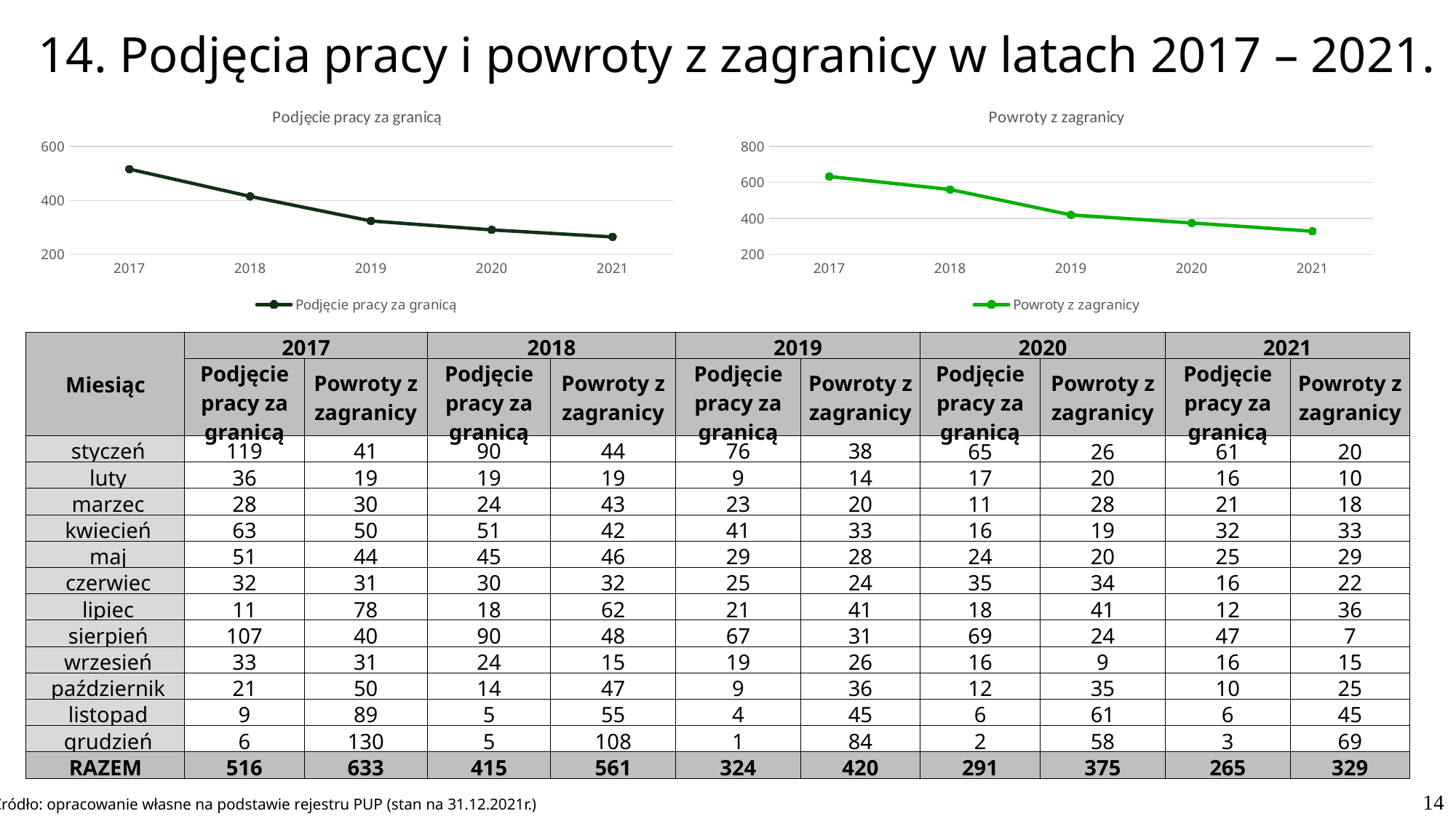
In the "Podjęcie pracy za granicą" chart, is the value for 2019 greater or less than 400? less In the "Powroty z zagranicy" chart, which is larger, the value for 2017 or the value for 2019? 2017 What kind of chart is the "Podjęcie pracy za granicą" chart? line chart In the "Podjęcie pracy za granicą" chart, which year has the highest value? 2017 What colour is the line in the "Powroty z zagranicy" chart? green How many series does the legend of the "Powroty z zagranicy" chart list? 1 In the "Podjęcie pracy za granicą" chart, which year has the lowest value? 2021 In the "Podjęcie pracy za granicą" chart, do the values rise or fall from 2017 to 2021? fall How many years are plotted in the "Powroty z zagranicy" chart? 5 In the "Powroty z zagranicy" chart, is the value for 2018 greater or less than 600? less In the "Powroty z zagranicy" chart, is the value for 2020 greater or less than 400? less